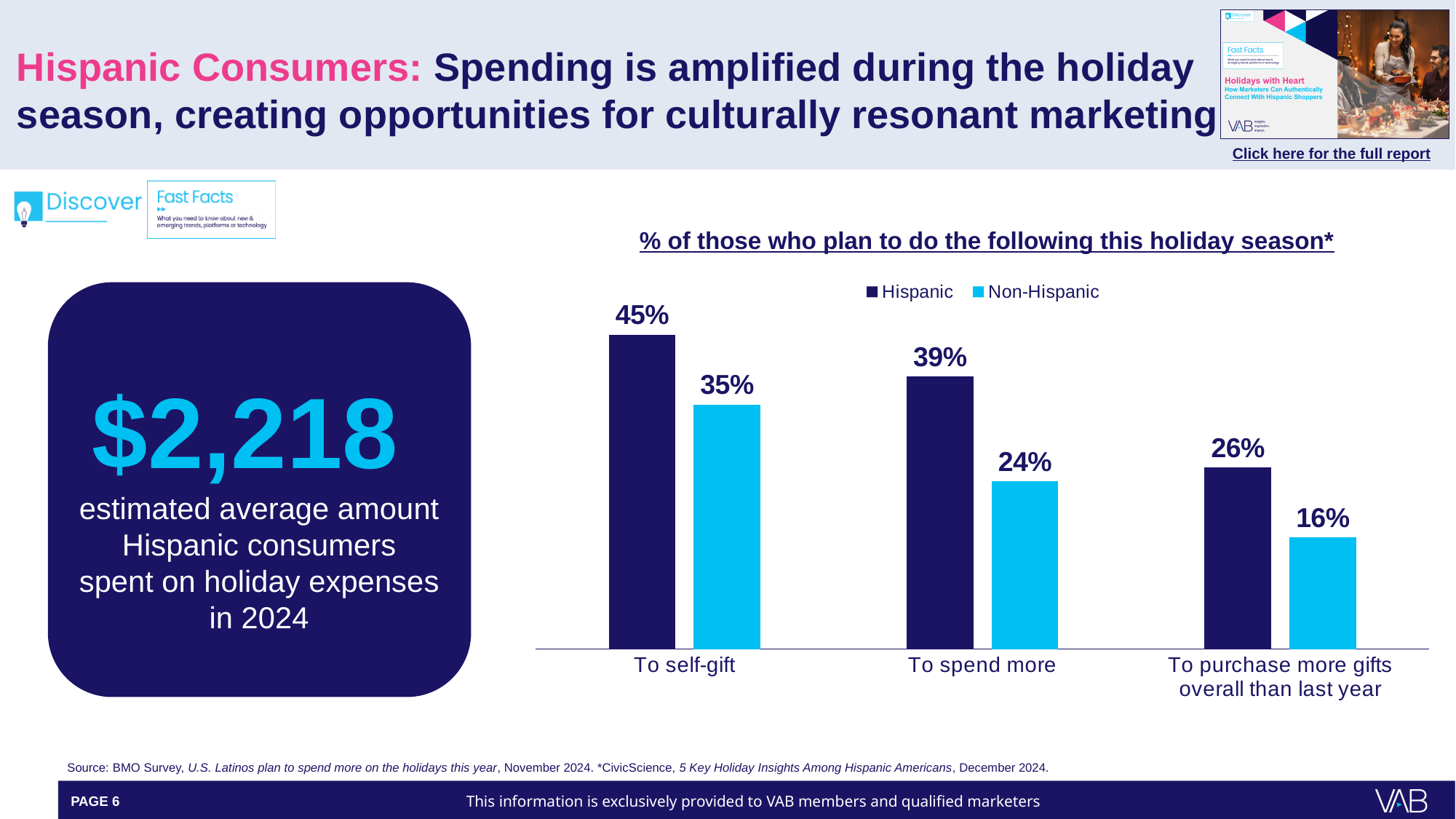
What percentage of Non-Hispanic consumers plan to spend more this holiday season? 24% How many series does the chart legend list? 2 What percentage of Hispanic consumers plan to self-gift this holiday season? 45% What is the title of the chart? % of those who plan to do the following this holiday season* What is the Non-Hispanic value for 'To purchase more gifts overall than last year'? 16% What is the difference between the Hispanic and Non-Hispanic values for 'To spend more'? 15 percentage points What kind of chart is shown on the slide? Bar chart Which category has the highest value for Hispanic consumers? To self-gift Which group has the larger value for 'To self-gift', Hispanic or Non-Hispanic? Hispanic Do the Hispanic values rise or fall moving from left to right across the categories? Fall Which category has the lowest value for Non-Hispanic consumers? To purchase more gifts overall than last year How many categories are shown on the x axis of the chart? 3